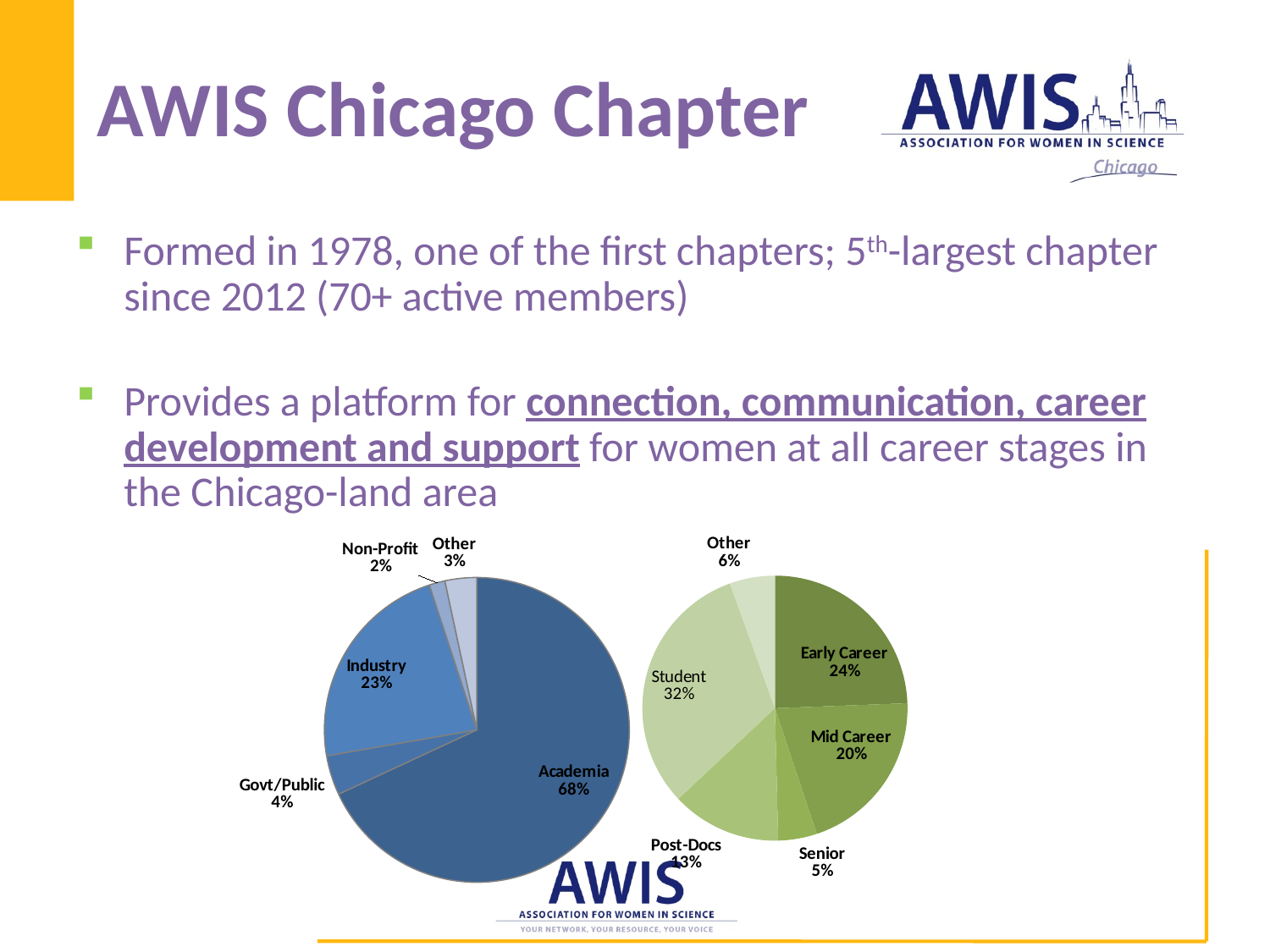
In the left pie chart, what share does Academia have? 68% In the right pie chart, which category has the smallest slice? Senior In the left pie chart, what share does Industry have? 23% In the right pie chart, what share does Early Career have? 24% In the right pie chart, what share does Student have? 32% In the left pie chart, what is the difference between the Academia and Industry shares? 45% How many slices does the left pie chart have? 5 In the right pie chart, which is larger, Mid Career or Other? Mid Career In the left pie chart, which category has the largest slice? Academia In the left pie chart, which category has the smallest slice? Non-Profit What type of chart is the right chart on the slide? Pie chart In the left pie chart, what share does Govt/Public have? 4%